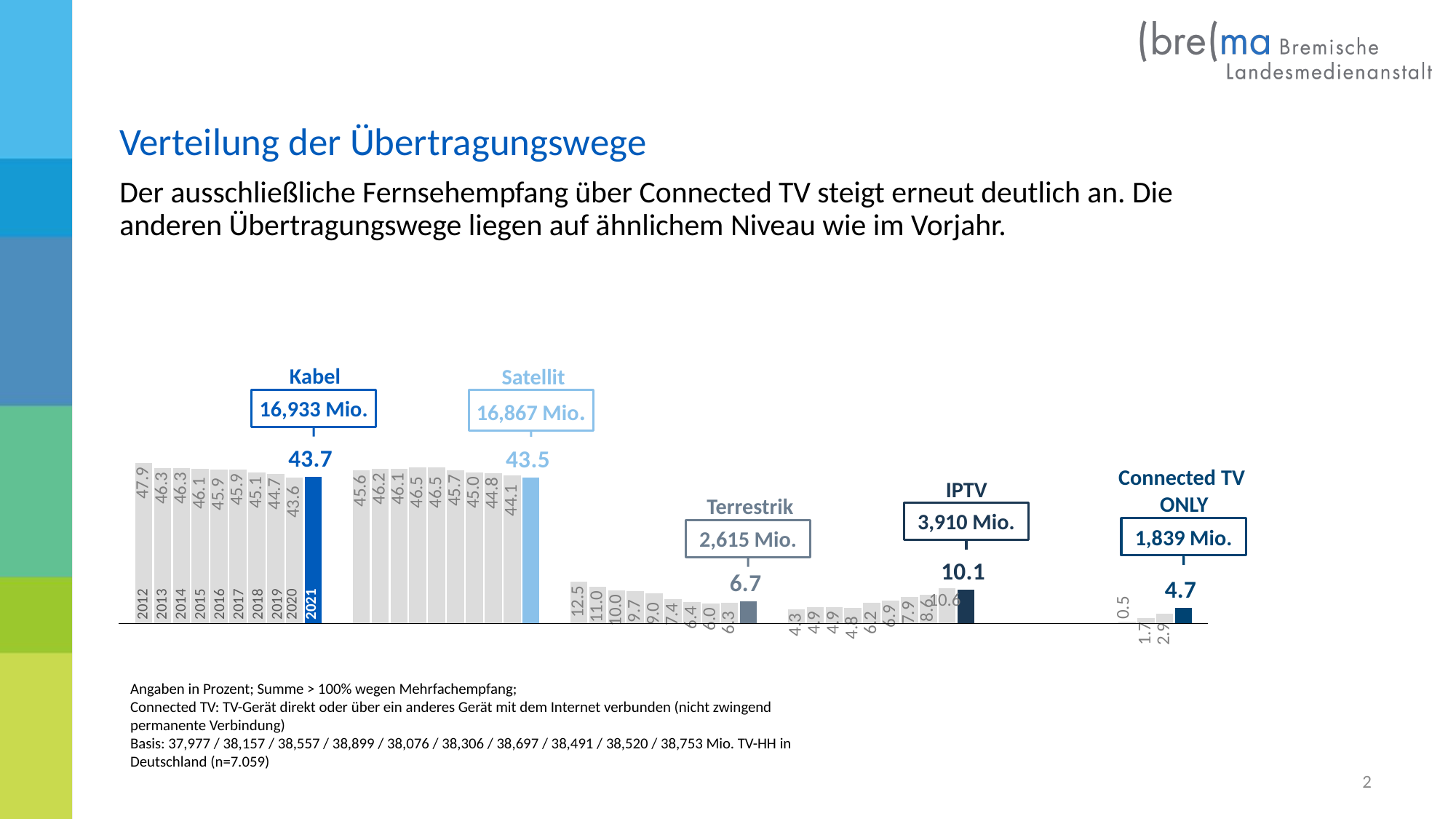
What is the 2021 value for Connected TV ONLY? 4.7 What is the 2021 value for Kabel? 43.7 How many million households does the label box for Terrestrik show? 2,615 Mio. Which transmission path has the highest 2021 value? Kabel Which transmission path has the lowest 2021 value? Connected TV ONLY How many yearly bars are shown in the Kabel group? 10 What is the difference between the 2021 values for IPTV and Terrestrik? 3.4 Which is larger, the 2021 value for Terrestrik or the 2021 value for Connected TV ONLY? Terrestrik What kind of chart is shown on the slide? bar chart Do the Kabel values generally rise or fall from 2012 to 2021? fall What is the 2021 value for Satellit? 43.5 What is the 2021 value for IPTV? 10.1